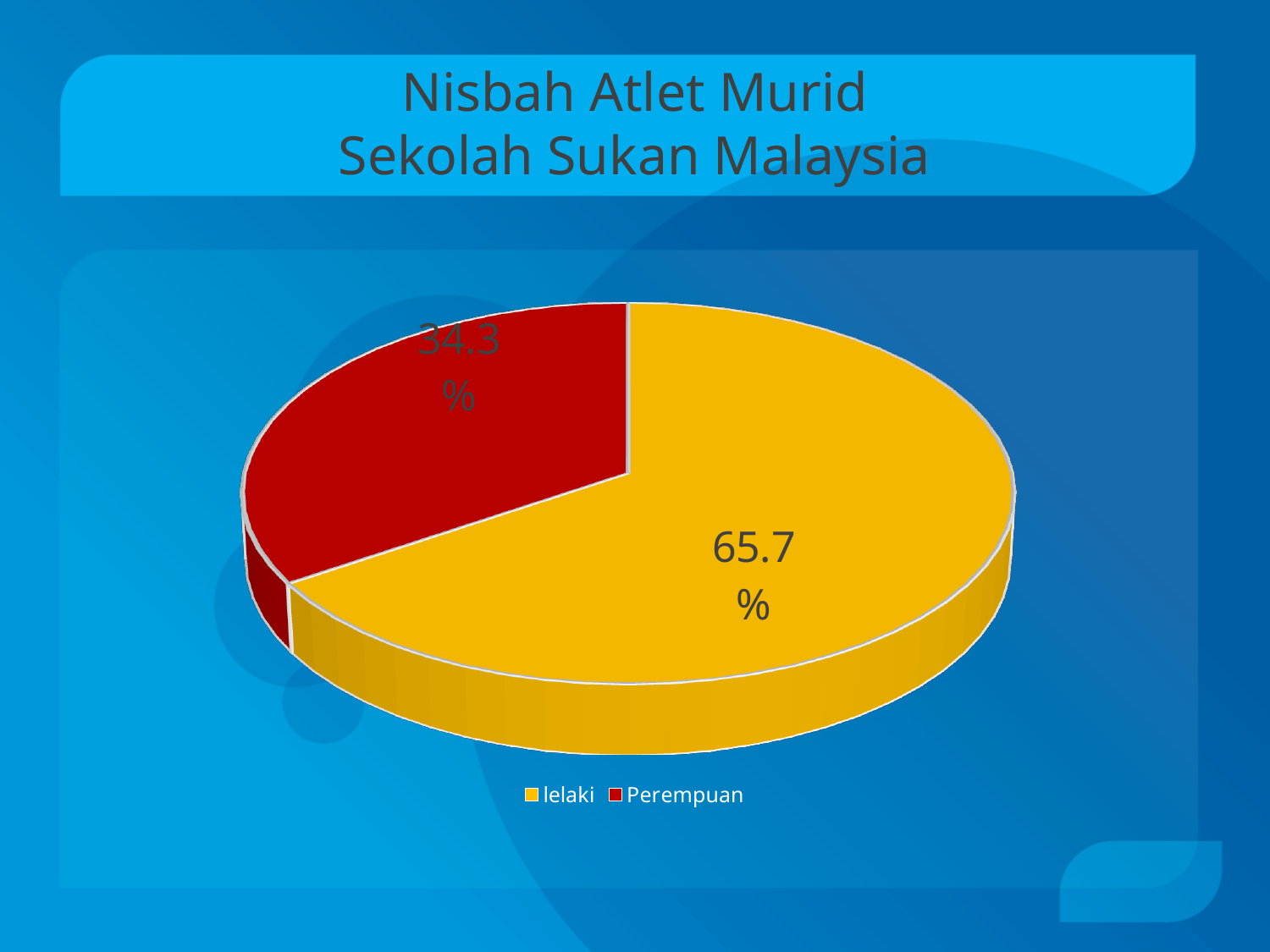
What colour is the lelaki slice? yellow Which is larger, the share for lelaki or the share for Perempuan? lelaki How many slices does the pie chart have? 2 What share of the pie does the Perempuan slice take? 34.3% What kind of chart is shown on the slide? pie chart What is the difference between the lelaki share and the Perempuan share? 31.4% What percentage of the pie is labelled for Perempuan? 34.3% What percentage of the pie is labelled for lelaki? 65.7% Which category has the smallest share of the pie? Perempuan Which category has the largest share of the pie? lelaki What is the title shown above the chart? Nisbah Atlet Murid Sekolah Sukan Malaysia How many entries does the legend list? 2